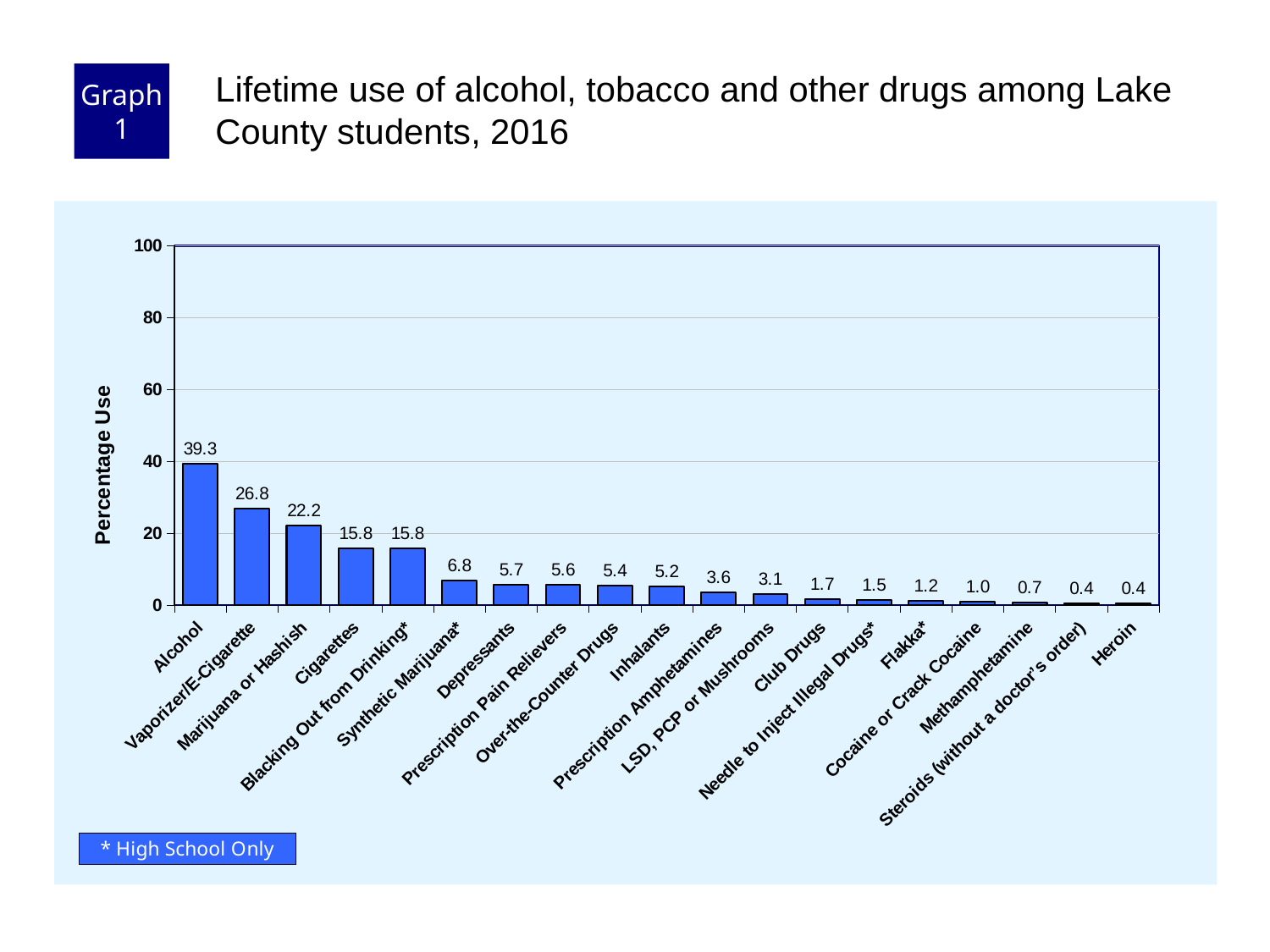
What is the difference in percentage use between Cigarettes and Inhalants? 10.6 Is the value for Vaporizer/E-Cigarette greater or less than 20? greater What kind of chart is shown on the slide? Bar chart What is the difference in percentage use between Alcohol and Marijuana or Hashish? 17.1 What is the percentage use for Synthetic Marijuana*? 6.8 Which category has the highest percentage use? Alcohol Which has a higher percentage use, Depressants or Club Drugs? Depressants What is the percentage use for Alcohol? 39.3 What is the percentage use for Vaporizer/E-Cigarette? 26.8 What is the percentage use for Methamphetamine? 0.7 How many categories are shown on the x axis? 19 What is the label of the y axis? Percentage Use